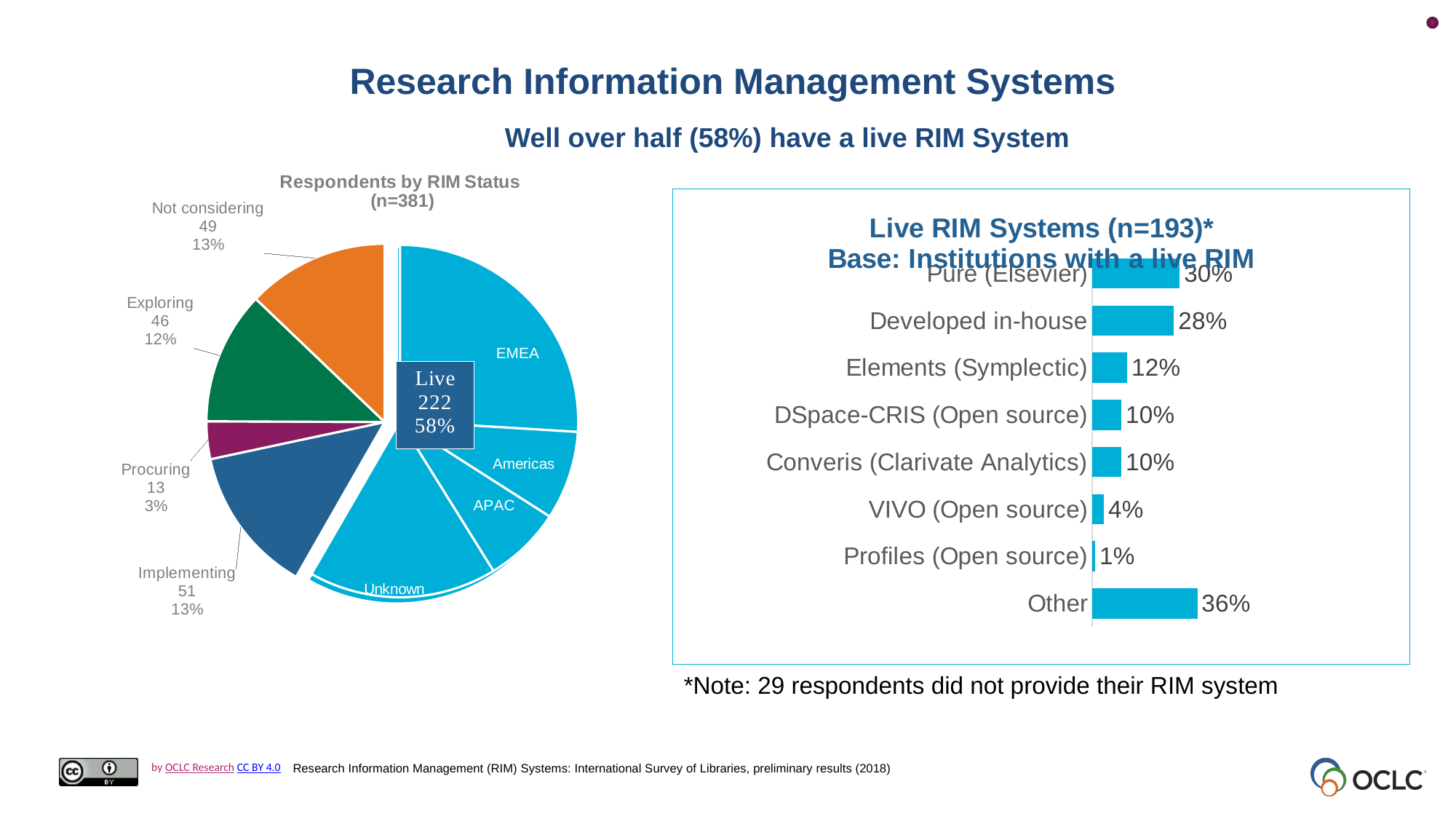
In the 'Respondents by RIM Status' pie chart, what is the difference in respondent counts between Implementing and Exploring? 5 How many categories are shown in the 'Live RIM Systems (n=193)' chart? 8 In the 'Live RIM Systems (n=193)' chart, which category has the highest percentage? Other In the 'Respondents by RIM Status' pie chart, how many respondents are in the Live category? 222 In the 'Live RIM Systems (n=193)' chart, what is the difference between the percentages for Pure (Elsevier) and Elements (Symplectic)? 18% In the 'Live RIM Systems (n=193)' chart, which is larger: VIVO (Open source) or DSpace-CRIS (Open source)? DSpace-CRIS (Open source) In the 'Live RIM Systems (n=193)' chart, which category has the lowest percentage? Profiles (Open source) In the 'Live RIM Systems (n=193)' chart, what percentage is shown for Developed in-house? 28% In the 'Respondents by RIM Status' pie chart, which status has the fewest respondents? Procuring In the 'Respondents by RIM Status' pie chart, what share of respondents are Exploring? 12% In the 'Live RIM Systems (n=193)' chart, what percentage is shown for Pure (Elsevier)? 30% What kind of chart is the 'Live RIM Systems (n=193)' chart? Bar chart